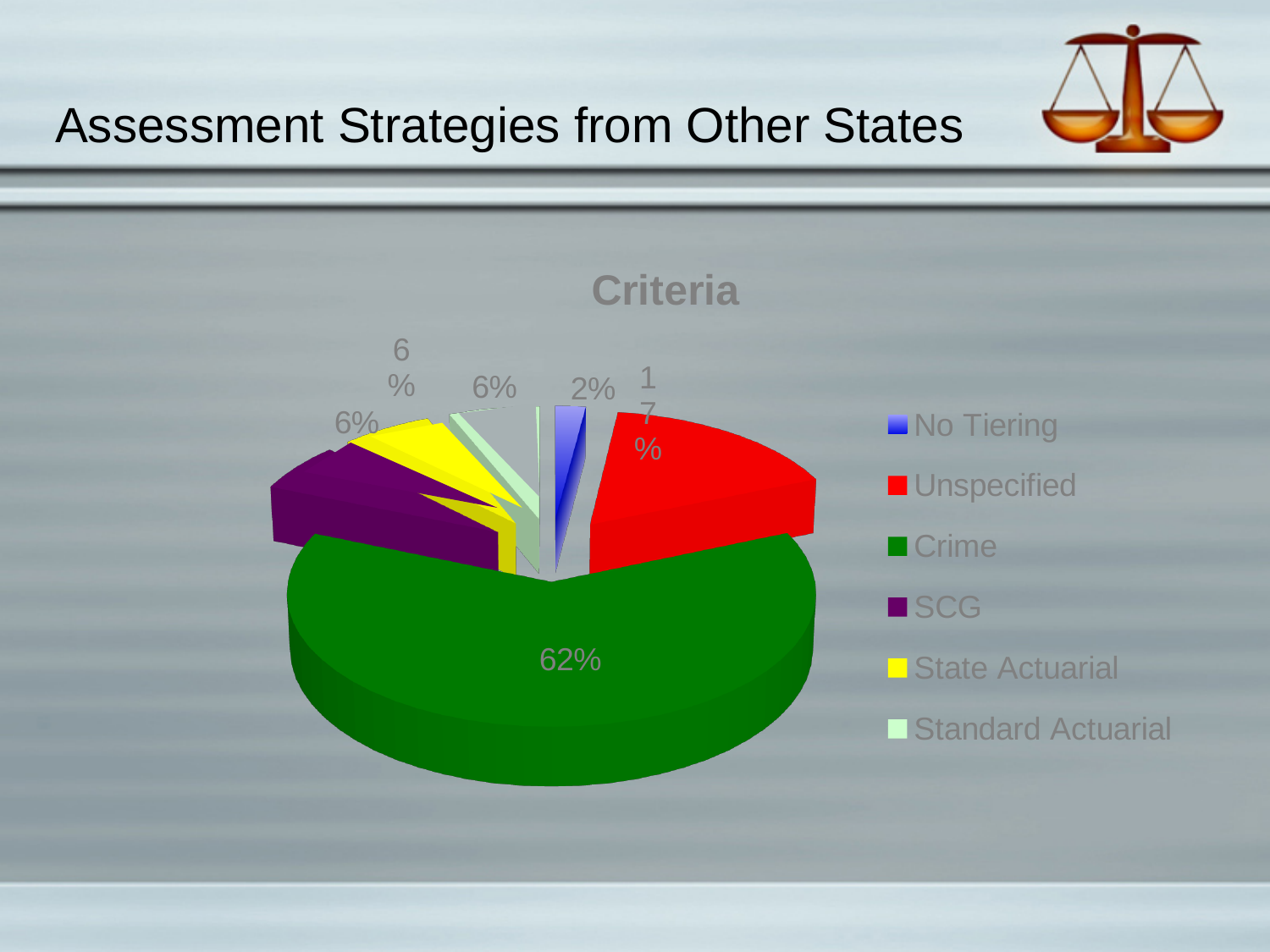
How many categories does the legend list? 6 Which has a larger share of the pie, Unspecified or No Tiering? Unspecified What colour is the slice representing Crime? green What percentage of the pie does Unspecified account for? 17% Which category has the largest share of the pie? Crime What percentage of the pie does No Tiering account for? 2% What percentage of the pie does Crime account for? 62% What percentage of the pie does SCG account for? 6% What is the title of the chart? Criteria Which category has the smallest share of the pie? No Tiering How many percentage points larger is the Crime share than the Unspecified share? 45 What kind of chart is shown on the slide? pie chart